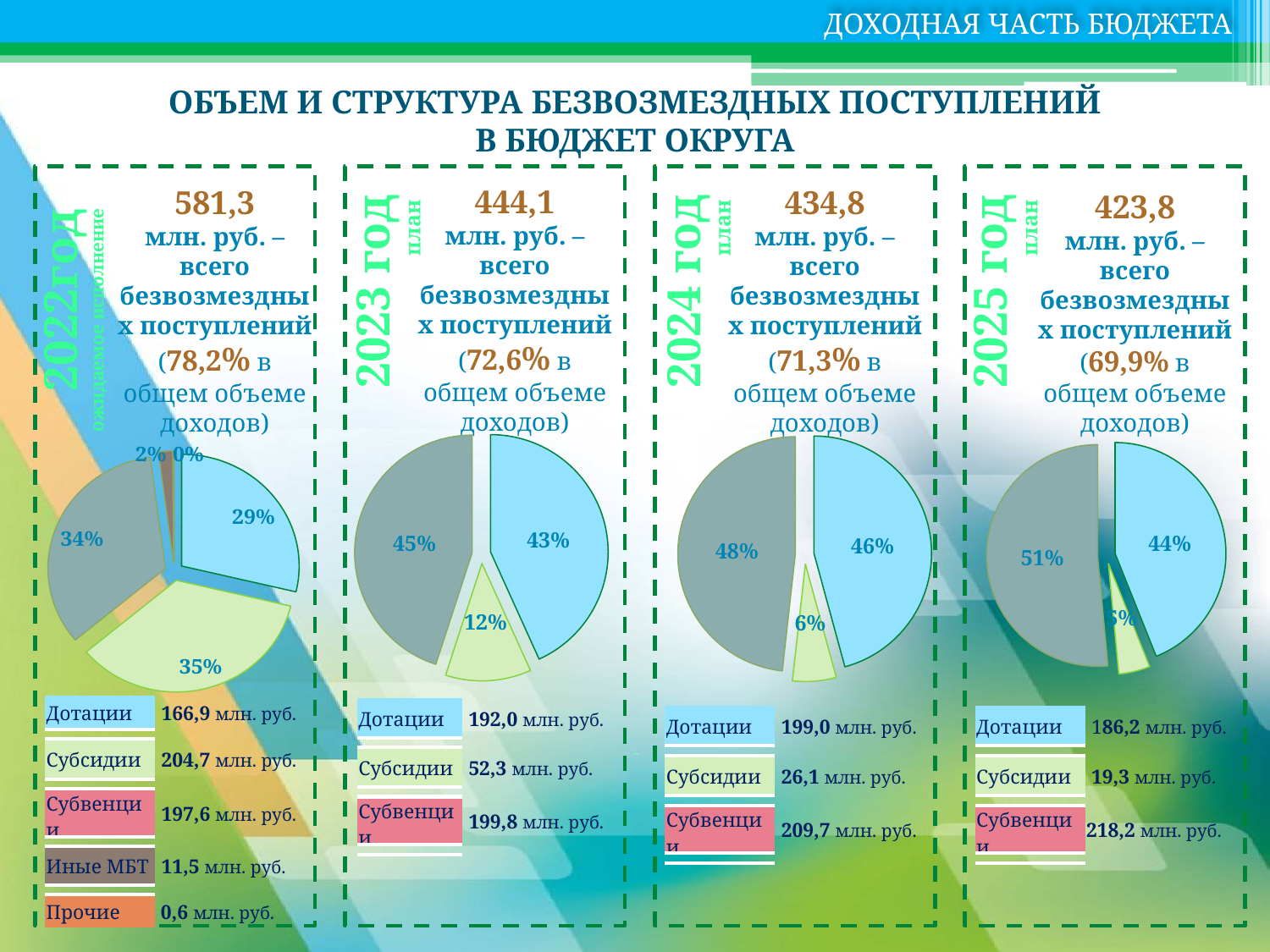
What kind of charts are shown on the slide? Pie charts In the 2022 год chart, which category has the largest value? Субсидии In the 2024 год chart, what is the value for Субвенции? 209,7 млн. руб. In the 2024 год chart, which is larger: Дотации or Субвенции? Субвенции In the 2023 год chart, how many categories does the legend list? 3 In the 2022 год chart, how many categories does the legend list? 5 In the 2023 год chart, which category has the smallest value? Субсидии In the 2023 год chart, what share of the pie is labelled for the light green (Субсидии) slice? 12% In the 2025 год chart, what is the value for Дотации? 186,2 млн. руб. In the 2022 год chart, what is the value for Субсидии? 204,7 млн. руб. How many pie charts are on the slide? 4 In the 2025 год chart, what is the difference between Субвенции and Дотации? 32,0 млн. руб.